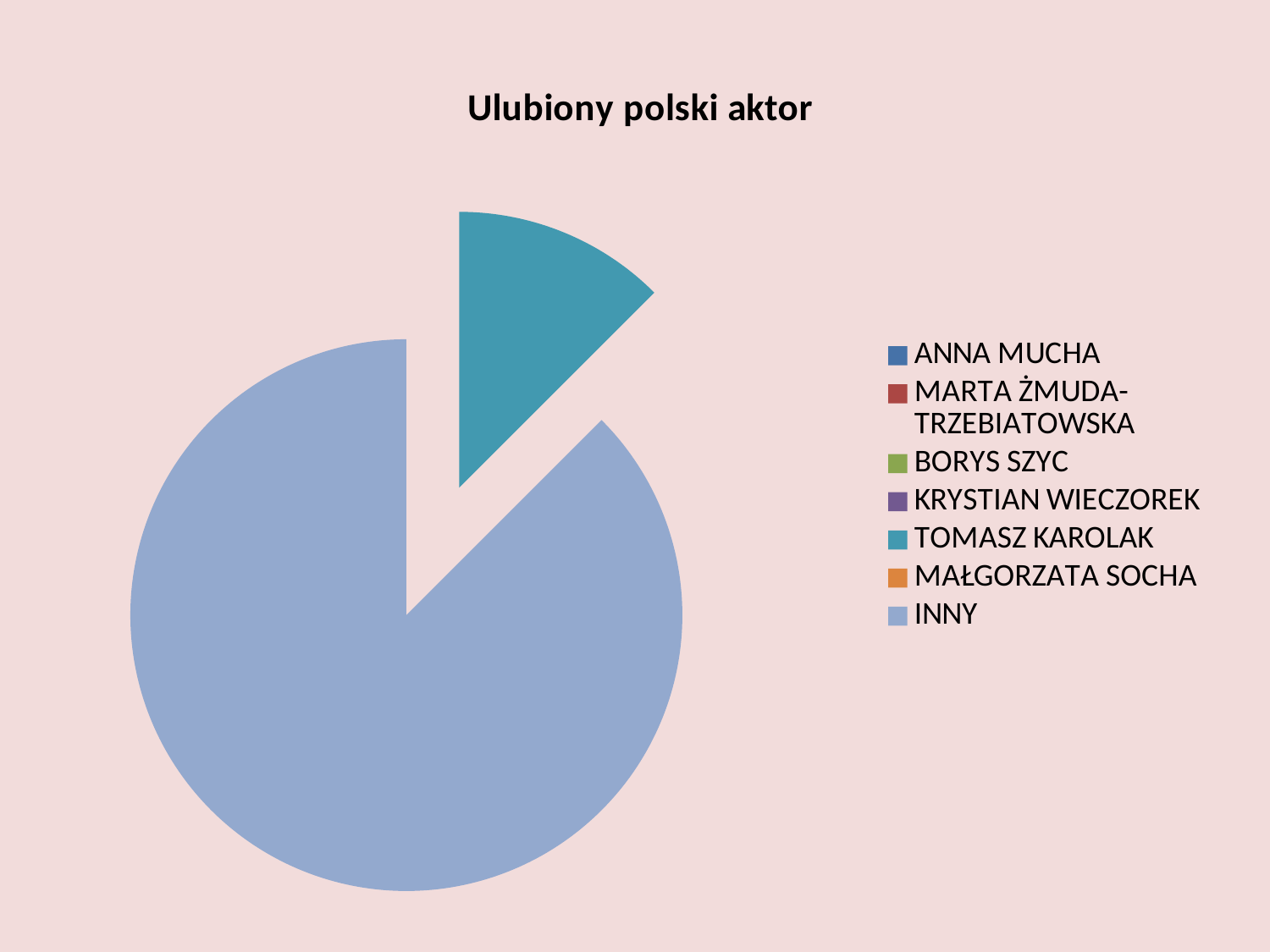
Which is larger, the slice for TOMASZ KAROLAK or the slice for INNY? INNY What kind of chart is shown on the slide? pie chart How many slices are visibly drawn in the pie? 2 Which category has the largest slice of the pie? INNY Is the slice for TOMASZ KAROLAK greater or less than half of the pie? less Is the slice for INNY greater or less than half of the pie? greater What is the title of the chart? Ulubiony polski aktor How many entries does the chart's legend list? 7 Which legend category other than INNY has a visible slice in the pie? TOMASZ KAROLAK